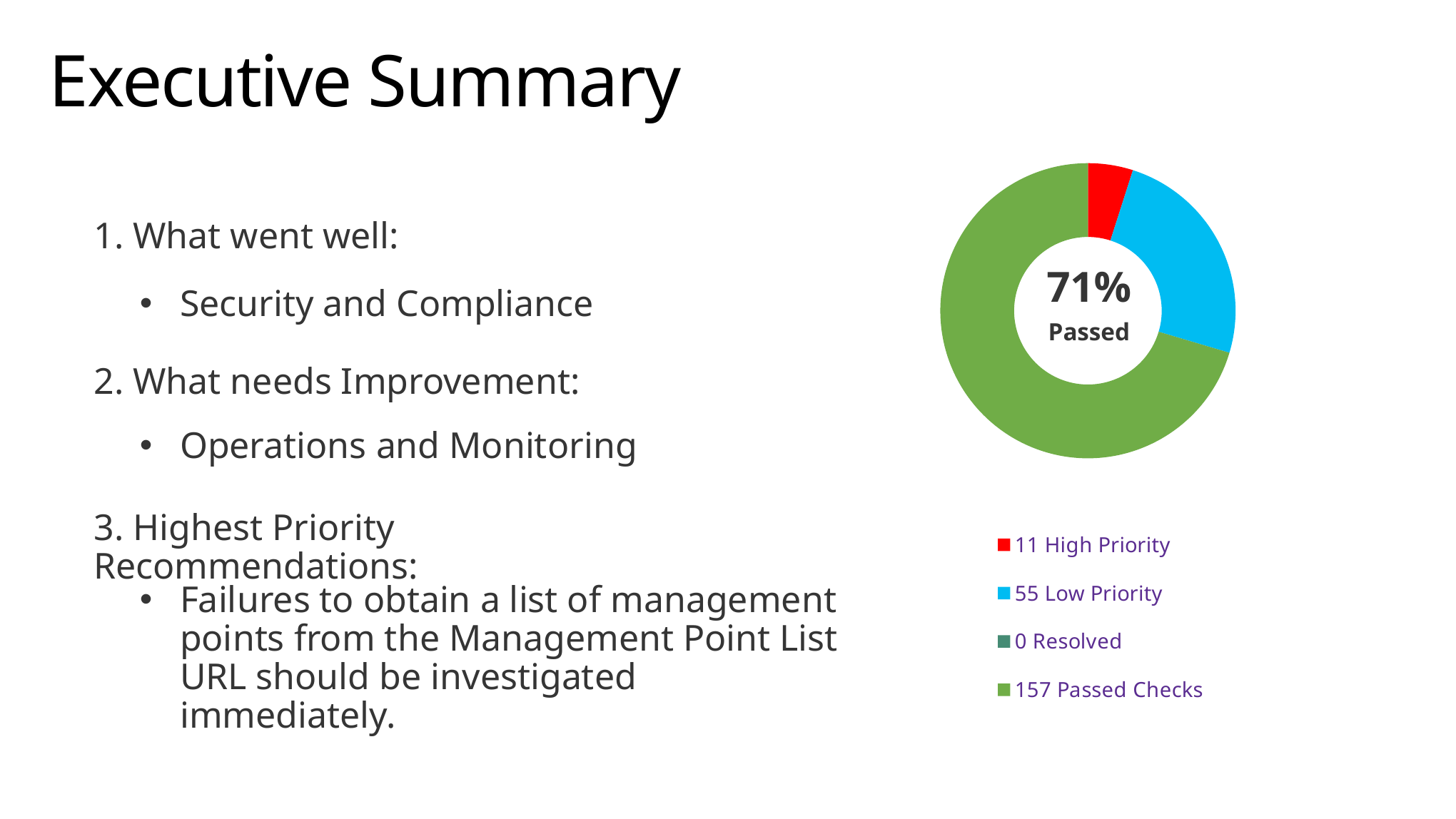
Which category has the smallest value in the chart? Resolved What percentage is shown in the centre of the donut chart as Passed? 71% How many categories does the chart legend list? 4 How many Low Priority items does the chart legend show? 55 Which category has the largest value in the chart? Passed Checks What is the difference between the number of Low Priority items and High Priority items? 44 How many Resolved items does the chart legend show? 0 How many High Priority items does the chart legend show? 11 How many Passed Checks does the chart legend show? 157 What kind of chart is shown on the slide? Donut (pie) chart Which is larger, the number of Low Priority items or the number of High Priority items? Low Priority What colour represents Passed Checks in the chart? Green